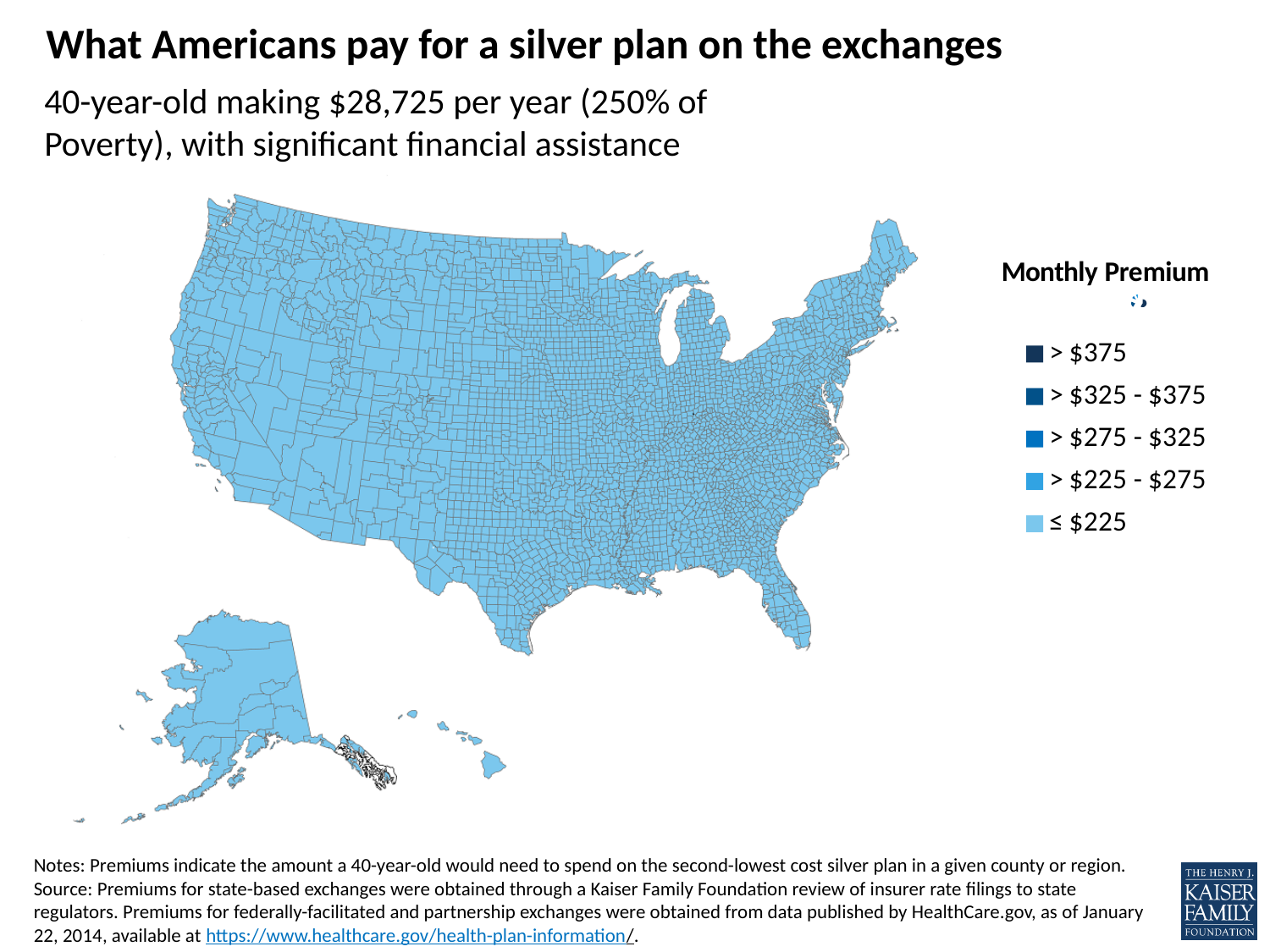
How many monthly premium categories does the legend list? 5 Is the monthly premium shown for counties on the map greater or less than $275? less What is the title of the legend on the map? Monthly Premium What kind of chart is shown on the slide? A map (choropleth map of the United States) Which legend category is shown with the lightest blue shade? ≤ $225 What is the highest monthly premium category listed in the legend? > $375 Which legend category covers monthly premiums between $325 and $375? > $325 - $375 Which monthly premium category does virtually the entire map fall into? ≤ $225 What is the lowest monthly premium category listed in the legend? ≤ $225 Which legend category covers monthly premiums between $275 and $325? > $275 - $325